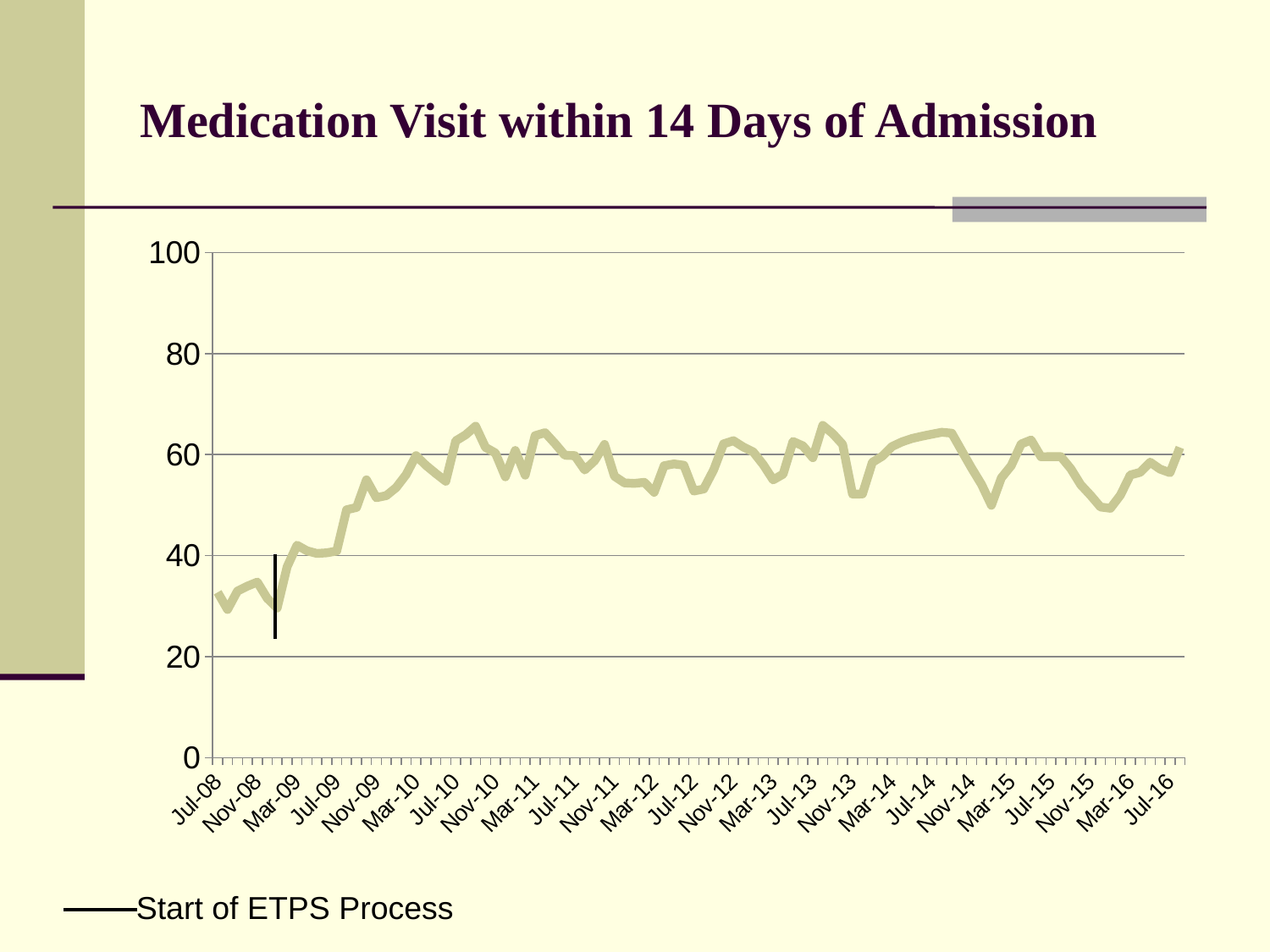
Does the line rise or fall between Jul-08 and Mar-10? rise How many entries does the legend list? 1 Which is larger, the value for Jul-08 or the value for Jul-16? Jul-16 What is the title of the chart? Medication Visit within 14 Days of Admission Which is larger, the value for Mar-09 or the value for Mar-10? Mar-10 What entry does the legend list? Start of ETPS Process Is the value for Jul-16 greater or less than 40? greater Is the value for Mar-14 greater or less than 40? greater Is the value for Jul-08 greater or less than 40? less What kind of chart is shown on the slide? line chart